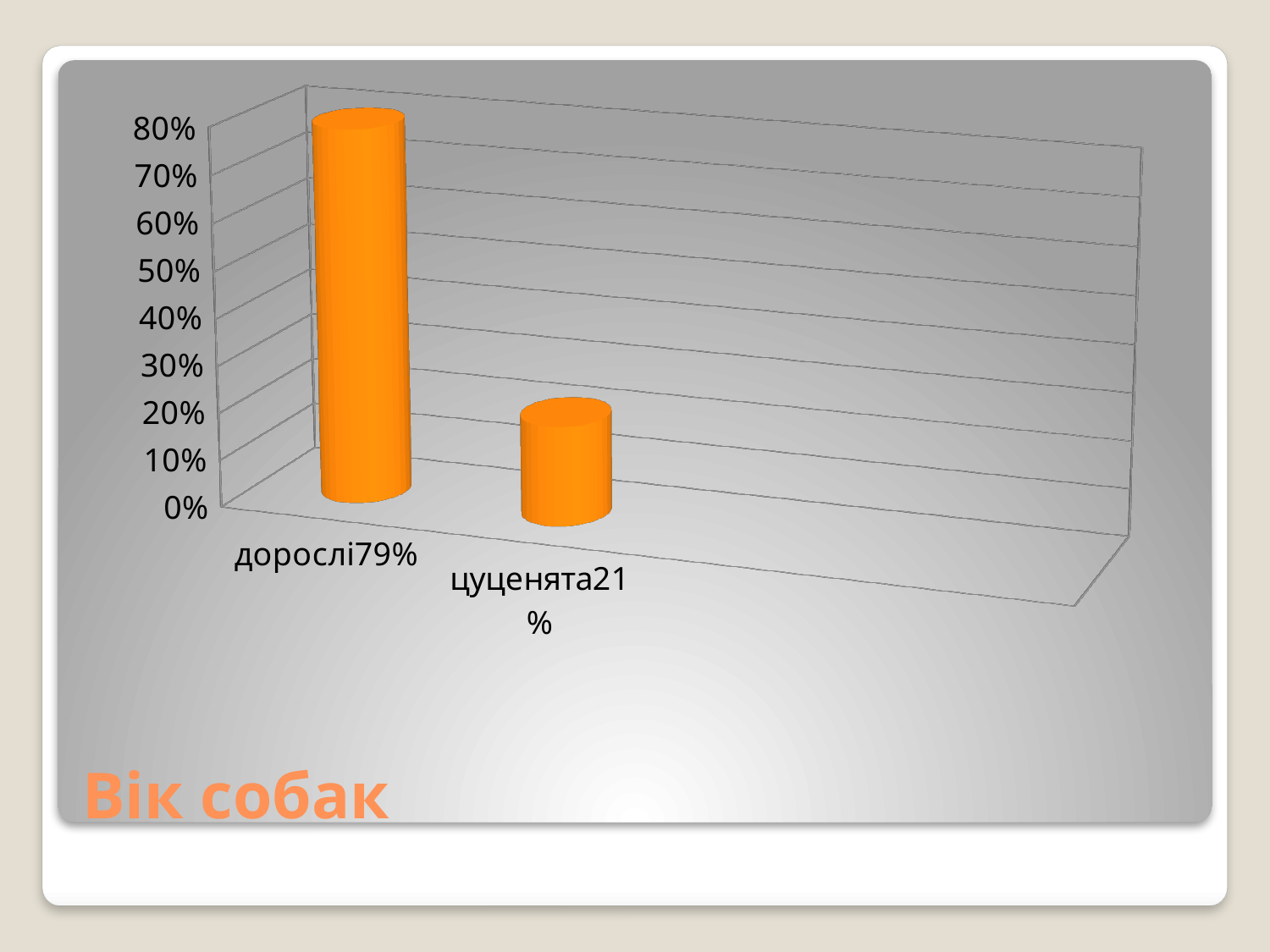
What is the title of the chart? Вік собак Which category has the lowest value? цуценята What percentage is shown for дорослі? 79% Which category has the highest value? дорослі Is the value for цуценята greater or less than 30%? less What is the difference between the value for дорослі and the value for цуценята? 58% What colour are the bars in the chart? orange What type of chart is shown on the slide? bar chart What percentage is shown for цуценята? 21% How many categories are plotted in the chart? 2 Is the value for дорослі greater or less than 70%? greater Which is larger, the value for дорослі or the value for цуценята? дорослі